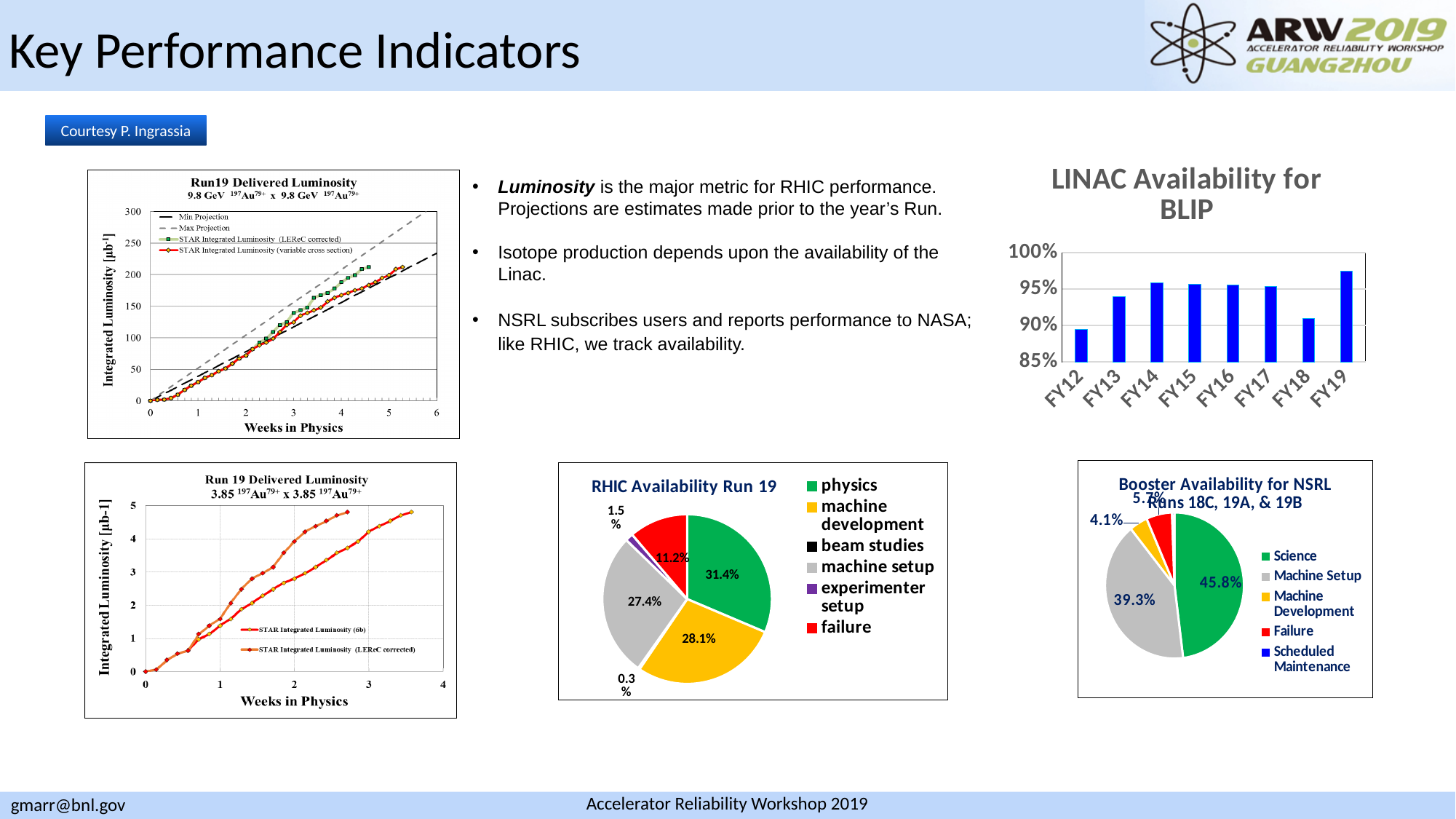
In the RHIC Availability Run 19 pie chart, what share is labelled for physics? 31.4% In the LINAC Availability for BLIP chart, which fiscal year has the highest availability? FY19 In the LINAC Availability for BLIP chart, which fiscal year has the lowest availability? FY12 How many fiscal years are shown in the LINAC Availability for BLIP bar chart? 8 In the RHIC Availability Run 19 pie chart, what is the difference between the machine development share and the machine setup share? 0.7% In the RHIC Availability Run 19 pie chart, what share is labelled for failure? 11.2% In the LINAC Availability for BLIP chart, is the value for FY12 greater or less than 90%? less In the Booster Availability for NSRL pie chart, what is the difference between the Science share and the Machine Setup share? 6.5% In the Booster Availability for NSRL pie chart, what share is labelled for Science? 45.8% How many entries does the legend of the RHIC Availability Run 19 pie chart list? 6 In the Booster Availability for NSRL pie chart, which is larger, Failure or Machine Development? Failure In the RHIC Availability Run 19 pie chart, which category has the largest slice? physics